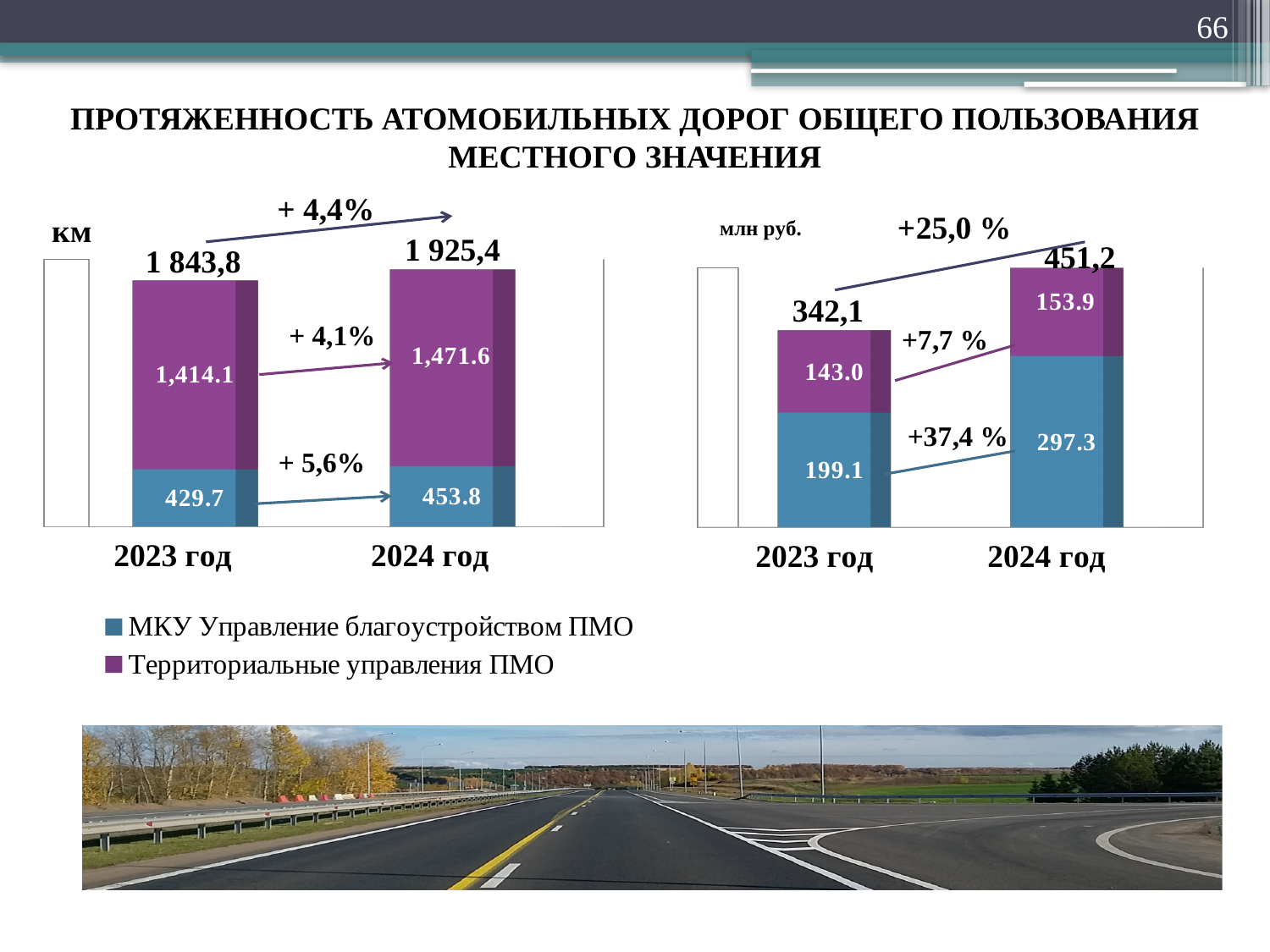
In the right chart (млн руб.), what is the total of the stacked bar for 2023 год? 342,1 In the right chart (млн руб.), which series has the larger value in 2024 год? МКУ Управление благоустройством ПМО In the right chart (млн руб.), what is the value for МКУ Управление благоустройством ПМО in 2024 год? 297.3 In the left chart (км), what is the value for МКУ Управление благоустройством ПМО in 2023 год? 429.7 In the left chart (км), what is the value for Территориальные управления ПМО in 2024 год? 1,471.6 How many series does the legend list? 2 In the right chart (млн руб.), what is the value for Территориальные управления ПМО in 2023 год? 143.0 In the left chart (км), which year has the larger value for Территориальные управления ПМО, 2023 год or 2024 год? 2024 год In the right chart (млн руб.), what is the difference between the МКУ Управление благоустройством ПМО values for 2024 год and 2023 год? 98.2 In the left chart (км), what is the total of the stacked bar for 2024 год? 1 925,4 What kind of chart is the left chart (км)? Stacked bar chart In the right chart (млн руб.), what percentage change is shown between the totals for 2023 год and 2024 год? +25,0 %